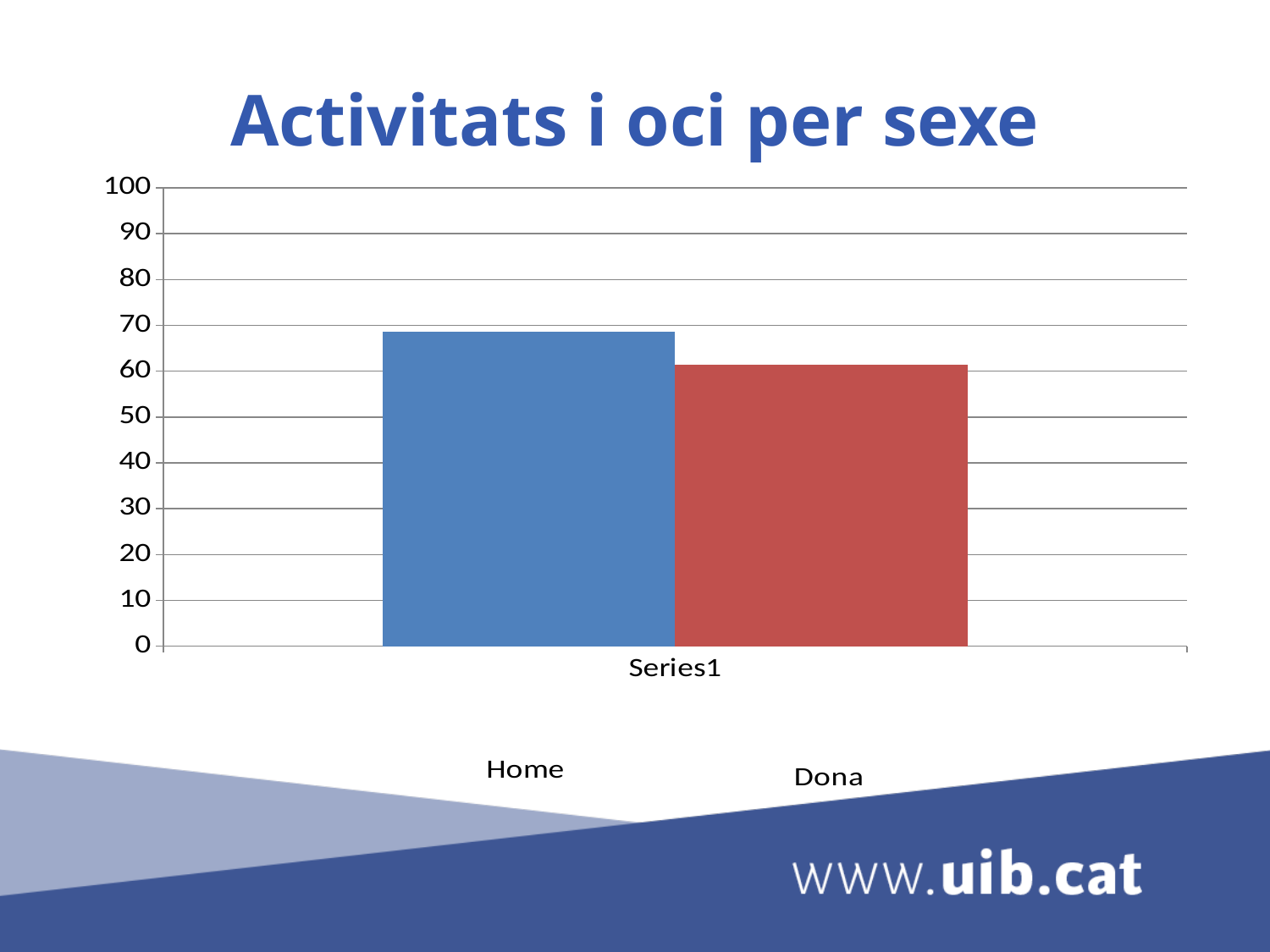
Which series has the highest bar? Home Is the value for Home greater or less than 60? greater Is the value for Dona greater or less than 70? less Is the value for Dona greater or less than 50? greater What kind of chart is shown on the slide? bar chart Which series has the lowest bar? Dona What colour is the bar for Dona? red How many series does the legend list? 2 How many bars are plotted in the chart? 2 Which series has the higher value, Home or Dona? Home What is the title of the chart? Activitats i oci per sexe